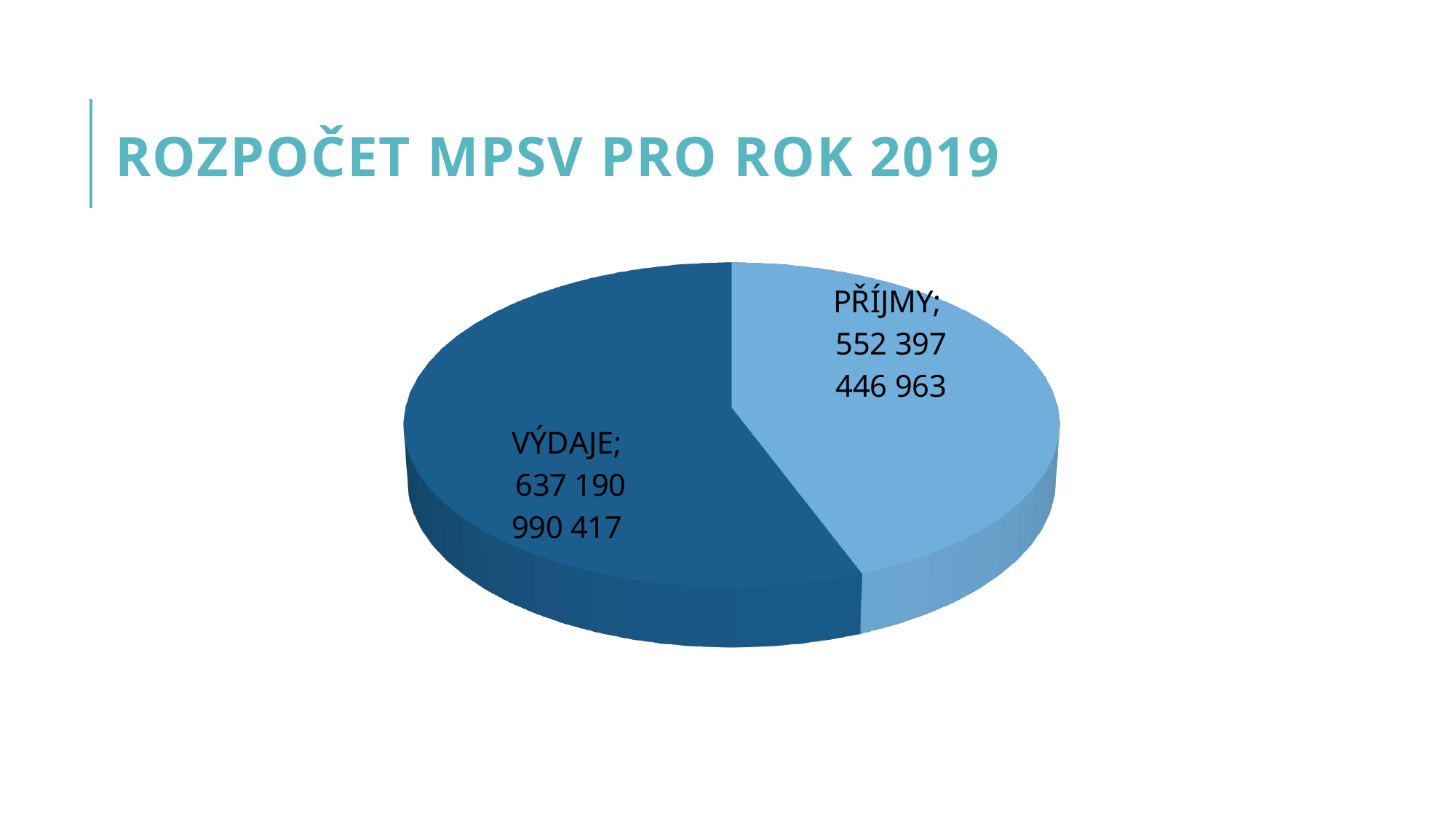
By how much does VÝDAJE exceed PŘÍJMY? 84 793 543 454 Which slice of the pie is the largest? VÝDAJE Which is larger, PŘÍJMY or VÝDAJE? VÝDAJE What is the total of PŘÍJMY and VÝDAJE? 1 189 588 437 380 Which slice of the pie is the smallest? PŘÍJMY Which slice is drawn in the lighter blue colour? PŘÍJMY How many slices does the pie chart have? 2 What is the value shown for VÝDAJE? 637 190 990 417 What is the value shown for PŘÍJMY? 552 397 446 963 What kind of chart is shown on the slide? pie chart What is the title of the chart on the slide? ROZPOČET MPSV PRO ROK 2019